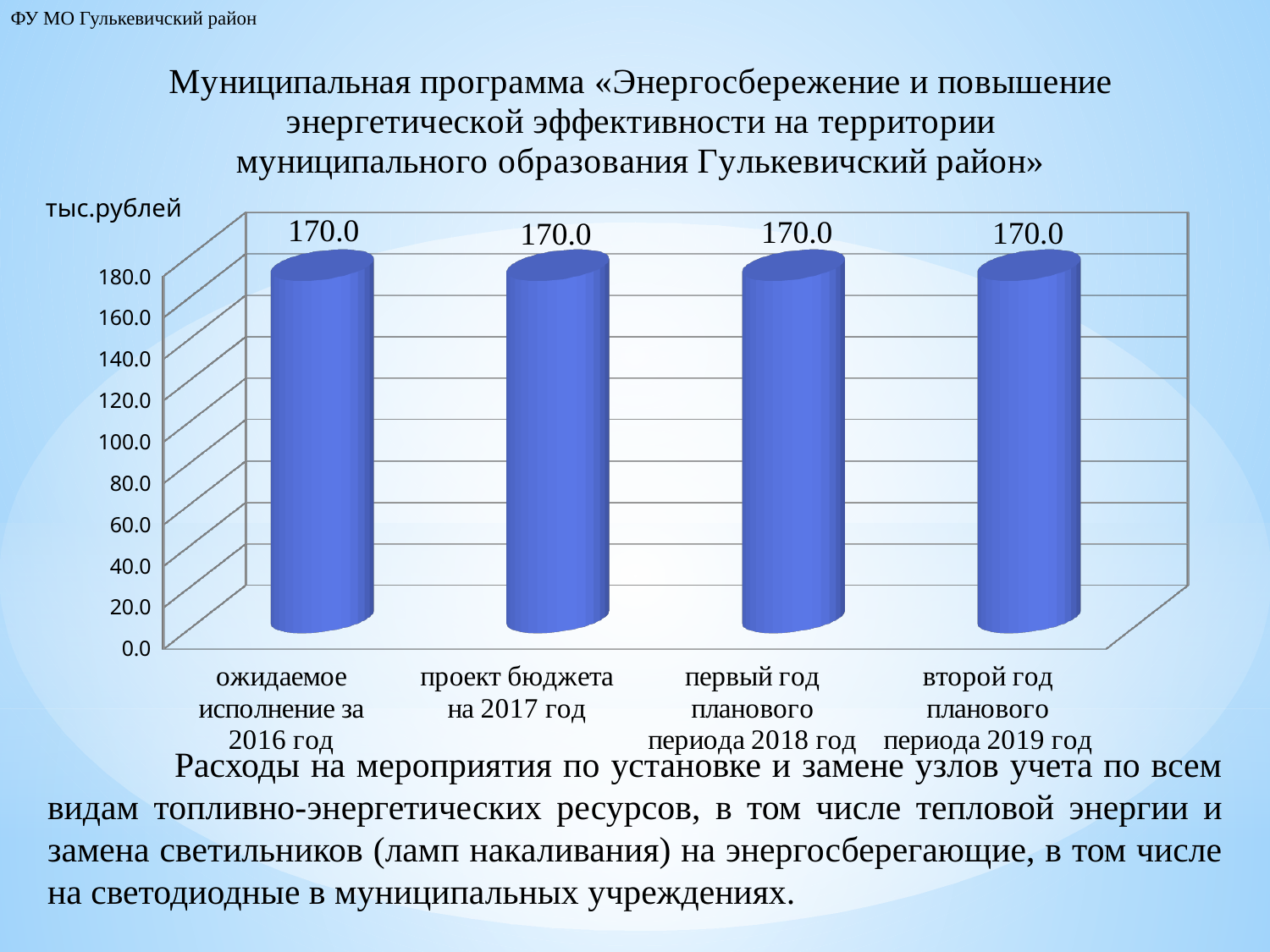
What is the value for 'ожидаемое исполнение за 2016 год'? 170.0 What is the value for 'первый год планового периода 2018 год'? 170.0 Is the value for 'второй год планового периода 2019 год' greater or less than 180.0? less What is the value for 'второй год планового периода 2019 год'? 170.0 What unit is indicated above the vertical axis of the chart? тыс.рублей Is the value for 'проект бюджета на 2017 год' greater or less than 160.0? greater What is the value for 'проект бюджета на 2017 год'? 170.0 What is the difference between the value for 2017 год and the value for 2016 год? 0.0 Which is larger: the value for 2018 год or the value for 2019 год? they are equal Do the values rise, fall, or stay the same from 2016 год to 2019 год? stay the same What kind of chart is shown on the slide? bar chart How many categories are shown on the chart? 4